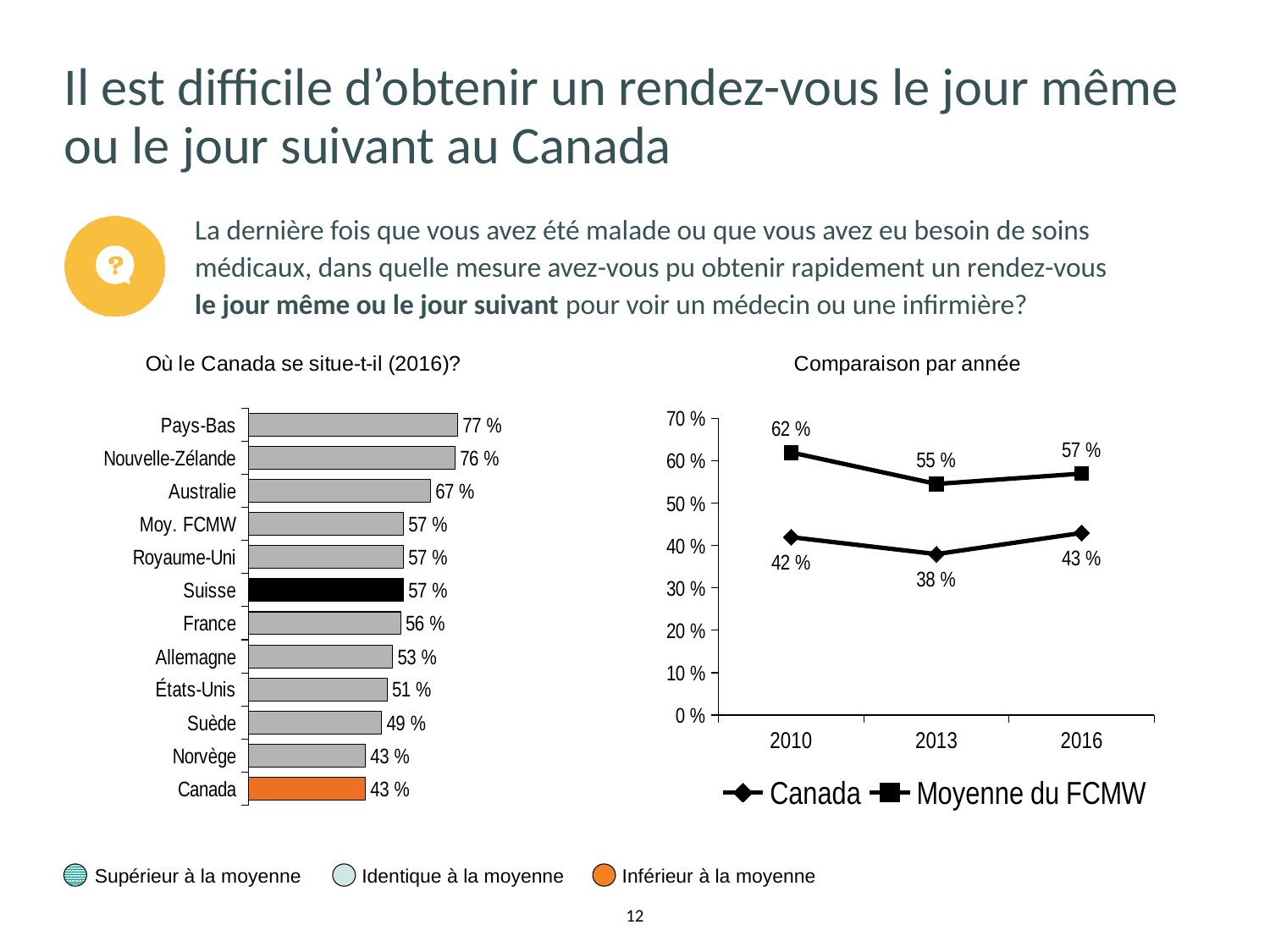
What kind of chart is 'Comparaison par année'? Line chart In the chart 'Comparaison par année', what is the value for Moyenne du FCMW in 2010? 62 % In the chart 'Où le Canada se situe-t-il (2016)?', what is the value for Australie? 67 % In the chart 'Comparaison par année', is the value for Canada in 2010 greater or less than 50 %? less How many countries or categories are shown in the chart 'Où le Canada se situe-t-il (2016)?'? 12 In the chart 'Où le Canada se situe-t-il (2016)?', which country has the highest value? Pays-Bas What kind of chart is 'Où le Canada se situe-t-il (2016)?'? Bar chart In the chart 'Comparaison par année', what is the difference between Moyenne du FCMW and Canada in 2016? 14 % How many series does the legend of the chart 'Comparaison par année' list? 2 In the chart 'Comparaison par année', what is the value for Canada in 2013? 38 % In the chart 'Où le Canada se situe-t-il (2016)?', which is larger, the value for Allemagne or the value for Suède? Allemagne In the chart 'Où le Canada se situe-t-il (2016)?', what is the difference between Pays-Bas and Canada? 34 %